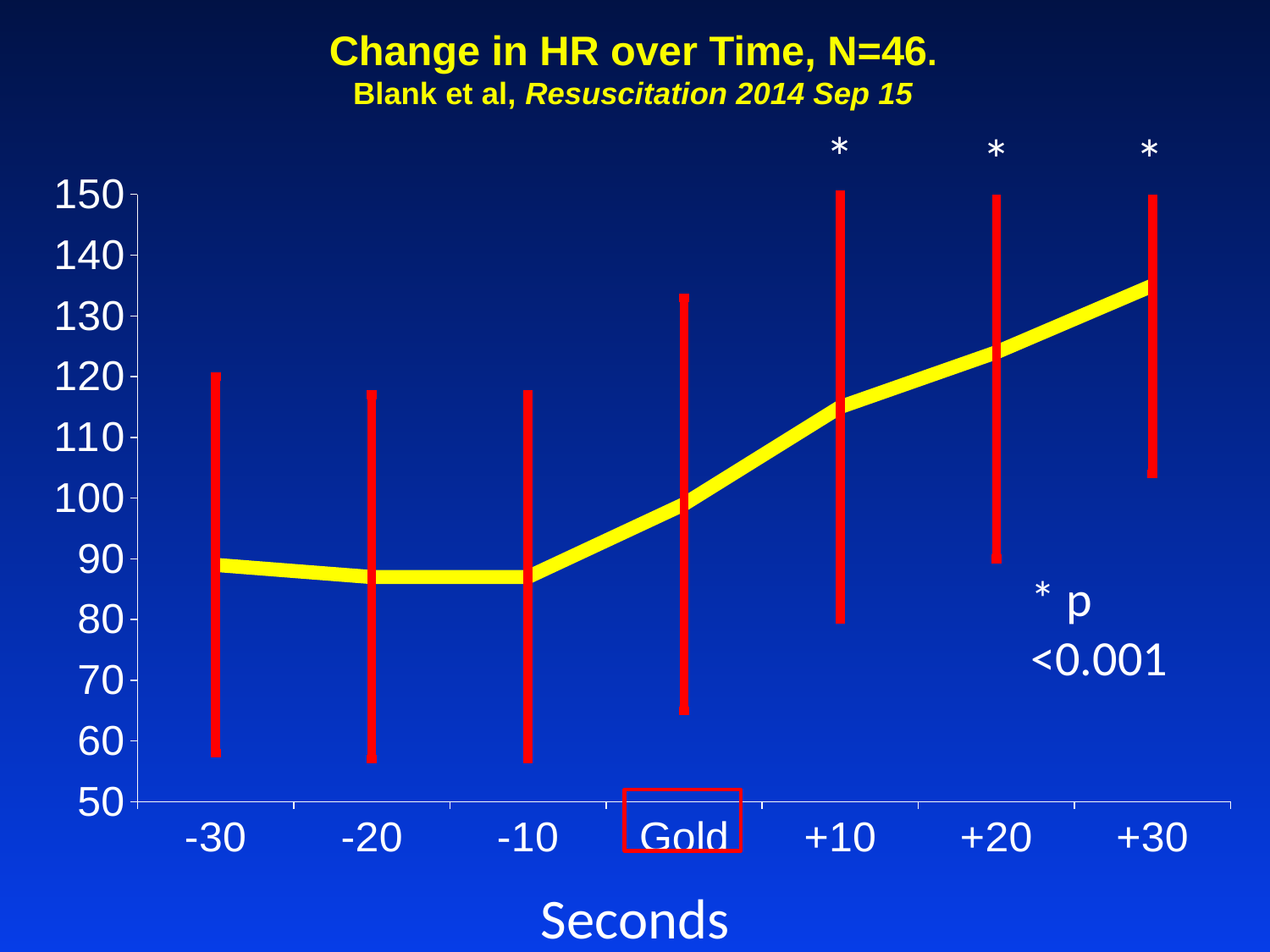
Is the value at -10 seconds greater or less than 100? less Which has the larger value, +10 seconds or Gold? +10 What is the label of the x axis? Seconds At which time point is the heart rate highest? +30 What is the title of the chart? Change in HR over Time, N=46. Is the value at +30 seconds greater or less than 120? greater Does the heart rate rise or fall from Gold to +30 seconds? rise Is the value at -30 seconds greater or less than 100? less What kind of chart is shown on the slide? line chart Which has the larger value, +30 seconds or -30 seconds? +30 How many time points are plotted along the x axis? 7